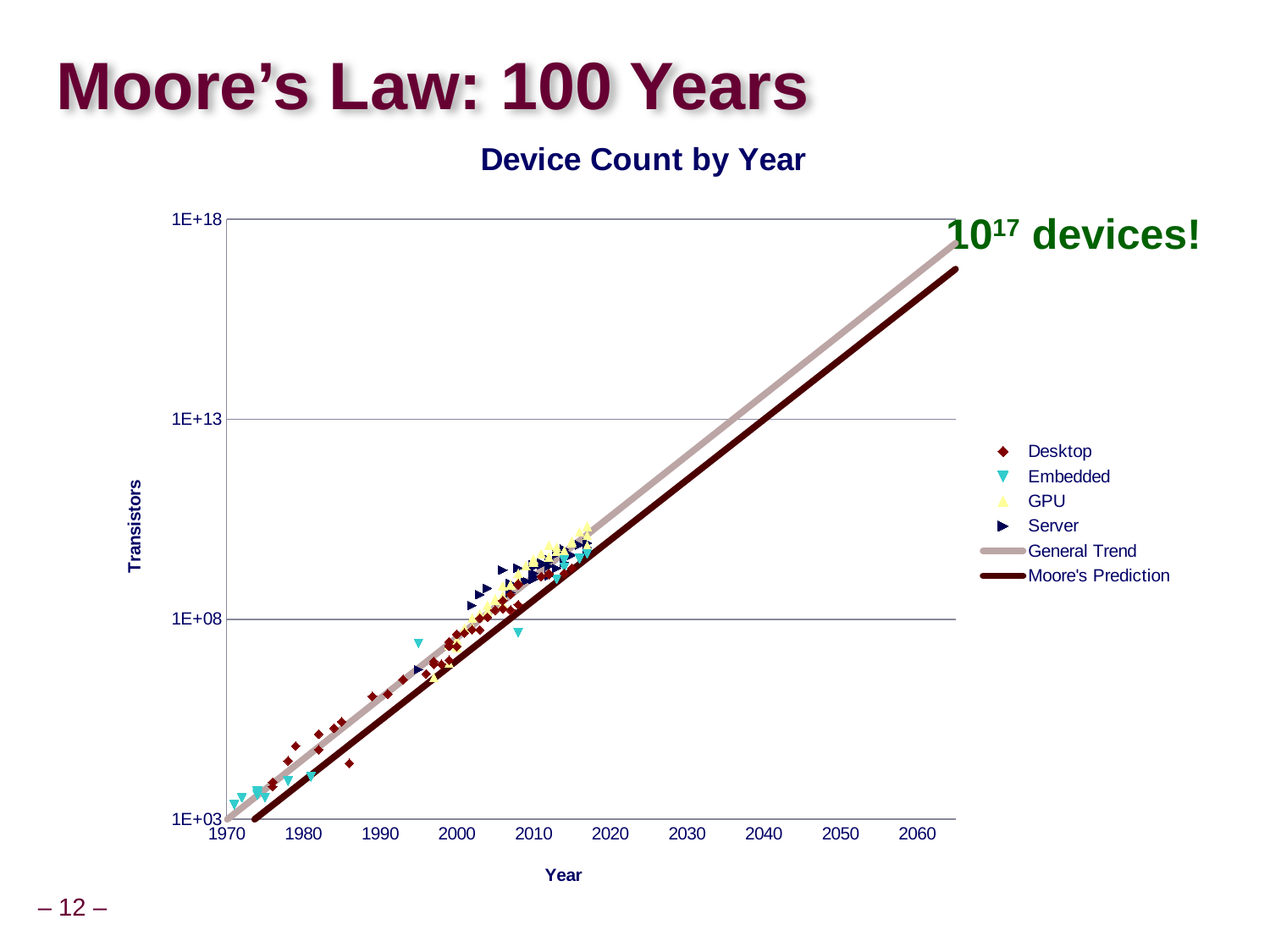
Do the transistor counts rise or fall as the year increases along the x axis? rise What is the last year labelled on the x axis? 2060 Are the GPU data points near 2015 greater or less than 1E+08 transistors? greater What is the label of the chart's x axis? Year What is the lowest value shown on the y axis? 1E+03 How many series does the chart's legend list? 6 What is the title of the chart? Device Count by Year What kind of chart is shown on the slide? scatter chart Is the Embedded data point near 2008 greater or less than 1E+08 transistors? less What is the highest value shown on the y axis? 1E+18 Is the Desktop data point near 1986 greater or less than 1E+08 transistors? less Which of the two lines, General Trend or Moore's Prediction, is higher at the right end of the chart? General Trend